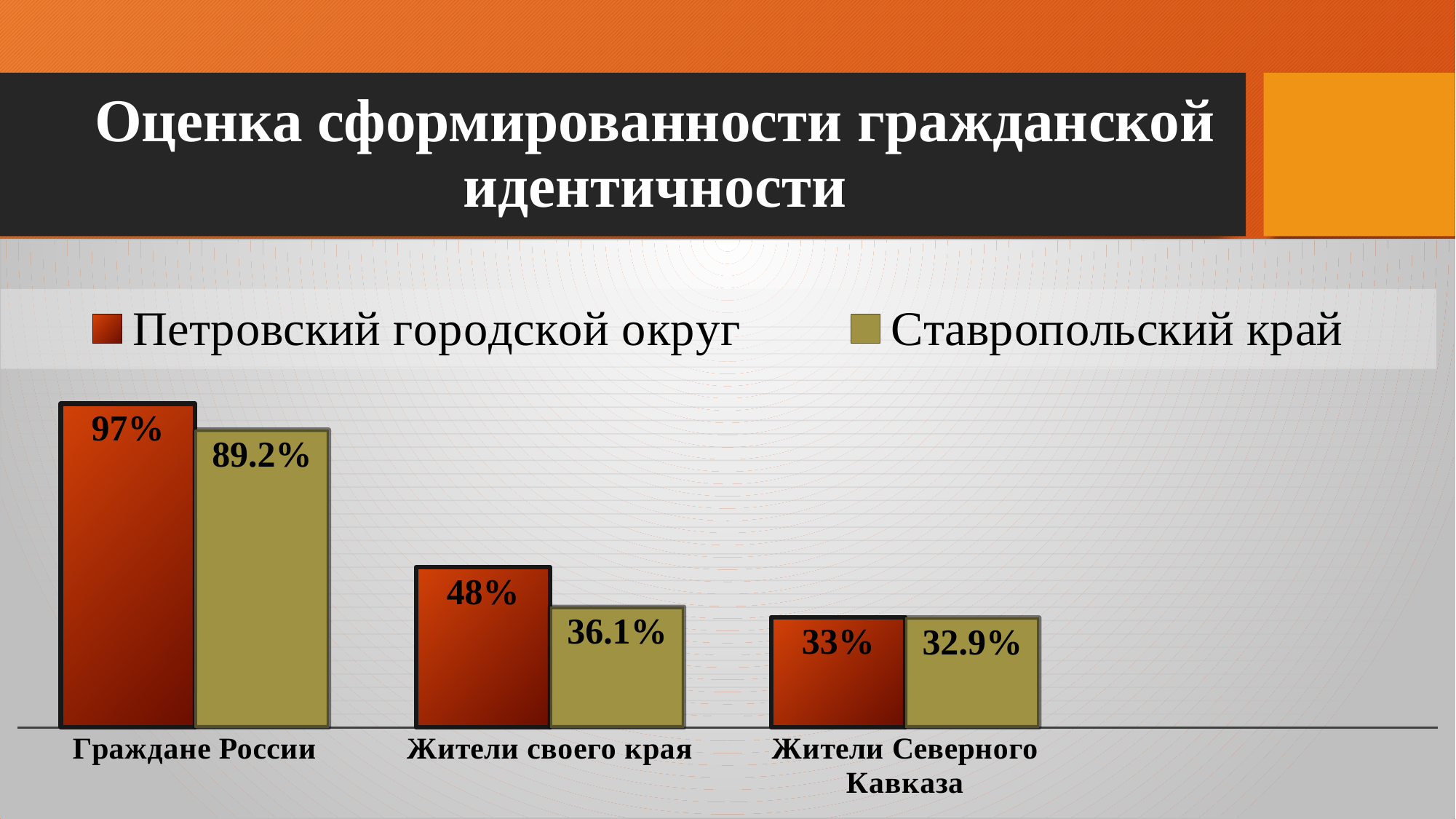
How many series does the legend list? 2 What kind of chart is shown on the slide? Bar chart Which category has the lowest value for Ставропольский край? Жители Северного Кавказа What is the value for Ставропольский край in the Жители своего края category? 36.1% What is the difference between the Петровский городской округ and Ставропольский край values in the Граждане России category? 7.8% What is the difference between the Петровский городской округ and Ставропольский край values in the Жители своего края category? 11.9% How many categories are shown on the x axis? 3 What is the value for Ставропольский край in the Жители Северного Кавказа category? 32.9% In the Жители своего края category, which series has the larger value? Петровский городской округ Which category has the highest value for Петровский городской округ? Граждане России What is the value for Петровский городской округ in the Граждане России category? 97% Do the values for Ставропольский край rise or fall from left to right along the x axis? Fall